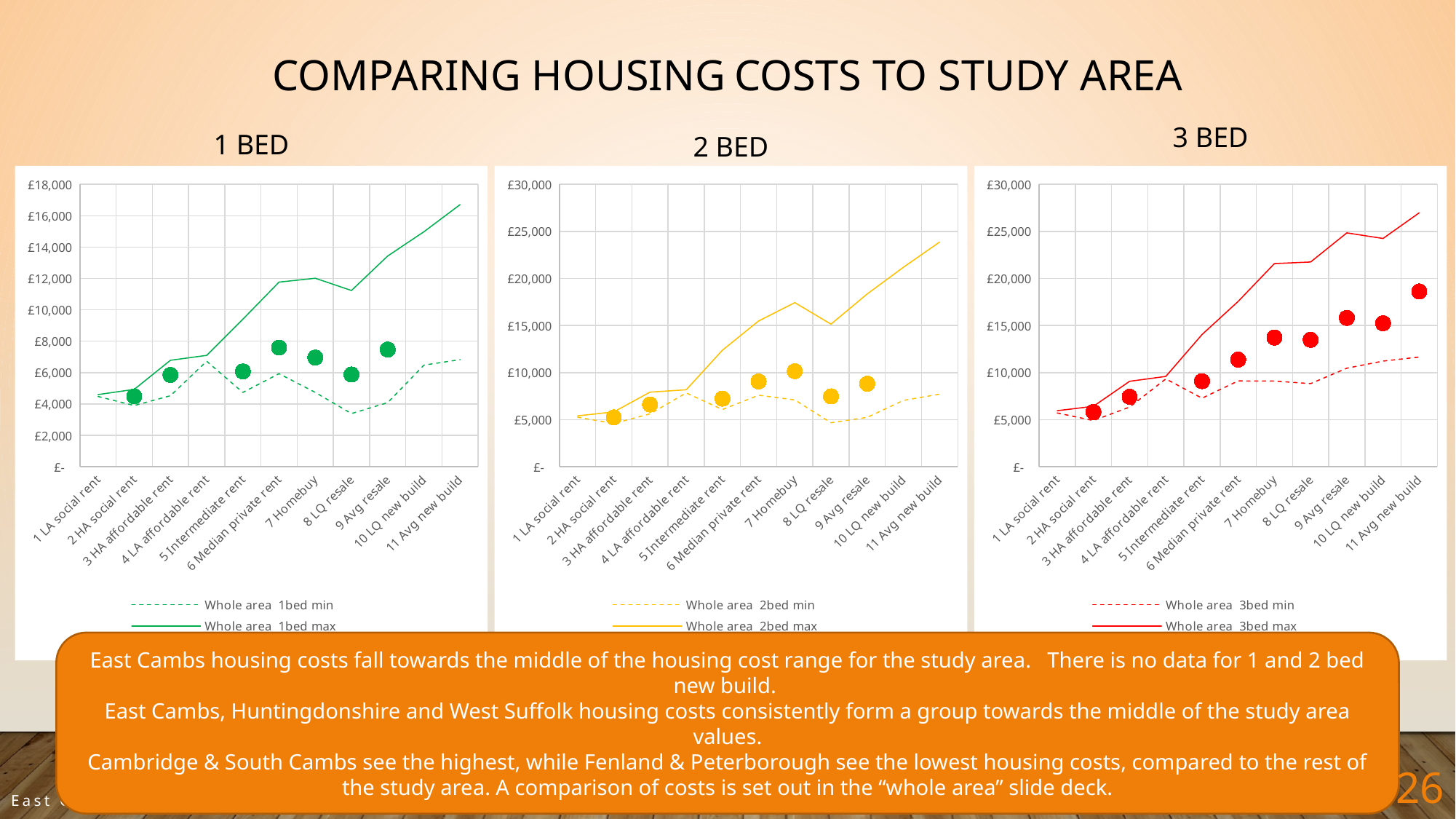
In the 2 BED chart, is the value of the Whole area 2bed max line at 11 Avg new build greater or less than £20,000? greater In the 1 BED chart, is the value of the Whole area 1bed min line at 8 LQ resale greater or less than £4,000? less In the 1 BED chart, is the value of the Whole area 1bed max line at 11 Avg new build greater or less than £14,000? greater How many categories are shown on the x axis of the 2 BED chart? 11 What kind of chart is the 1 BED chart? line chart In the 3 BED chart, does the Whole area 3bed max line generally rise or fall from 1 LA social rent to 11 Avg new build? rise In the 1 BED chart, which legend entry is drawn with a dashed line? Whole area 1bed min